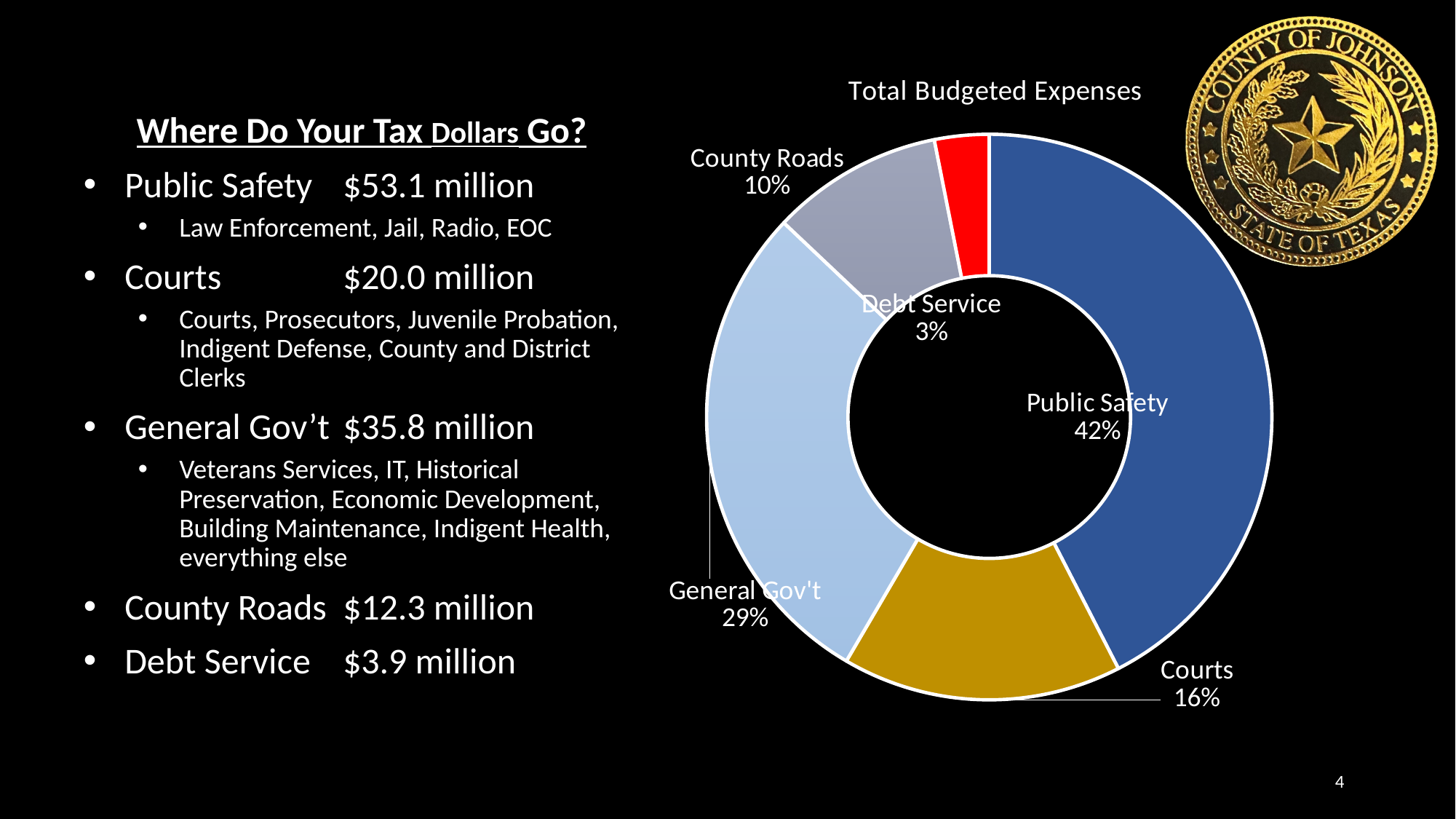
What share of Total Budgeted Expenses goes to County Roads? 10% What share of Total Budgeted Expenses goes to Public Safety? 42% Which category has the smallest share of Total Budgeted Expenses? Debt Service What is the difference in percentage points between the Public Safety and General Gov't shares? 13 Which has a larger share, Courts or County Roads? Courts What is the title of the chart? Total Budgeted Expenses What share of Total Budgeted Expenses goes to Debt Service? 3% How many categories are shown in the chart? 5 Which category has the largest share of Total Budgeted Expenses? Public Safety What kind of chart is shown on the slide? Doughnut chart